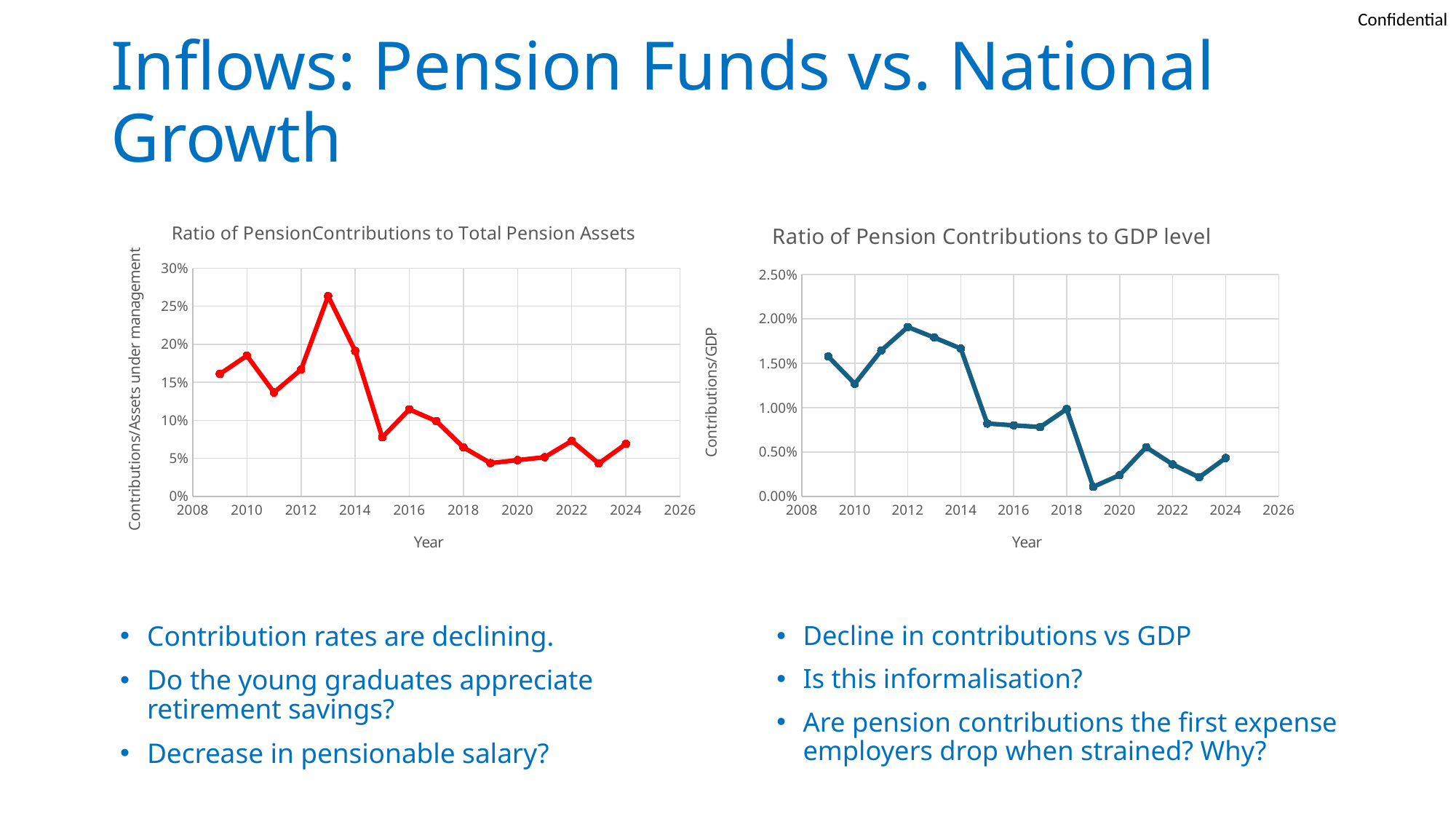
In the 'Ratio of PensionContributions to Total Pension Assets' chart, is the value for 2015 greater or less than 10%? less In the 'Ratio of PensionContributions to Total Pension Assets' chart, which year has the highest value? 2013 In the 'Ratio of Pension Contributions to GDP level' chart, is the value for 2015 greater or less than 1.00%? less In the 'Ratio of Pension Contributions to GDP level' chart, which is larger, the value for 2010 or the value for 2011? 2011 What kind of chart is the 'Ratio of Pension Contributions to GDP level' chart? line chart In the 'Ratio of PensionContributions to Total Pension Assets' chart, is the value for 2013 greater or less than 20%? greater In the 'Ratio of Pension Contributions to GDP level' chart, which year has the highest value? 2012 In the 'Ratio of Pension Contributions to GDP level' chart, do the values generally rise or fall from 2009 to 2024? fall In the 'Ratio of Pension Contributions to GDP level' chart, which year has the lowest value? 2019 How many data points are plotted in the 'Ratio of PensionContributions to Total Pension Assets' chart? 16 What is the y-axis label of the 'Ratio of Pension Contributions to GDP level' chart? Contributions/GDP